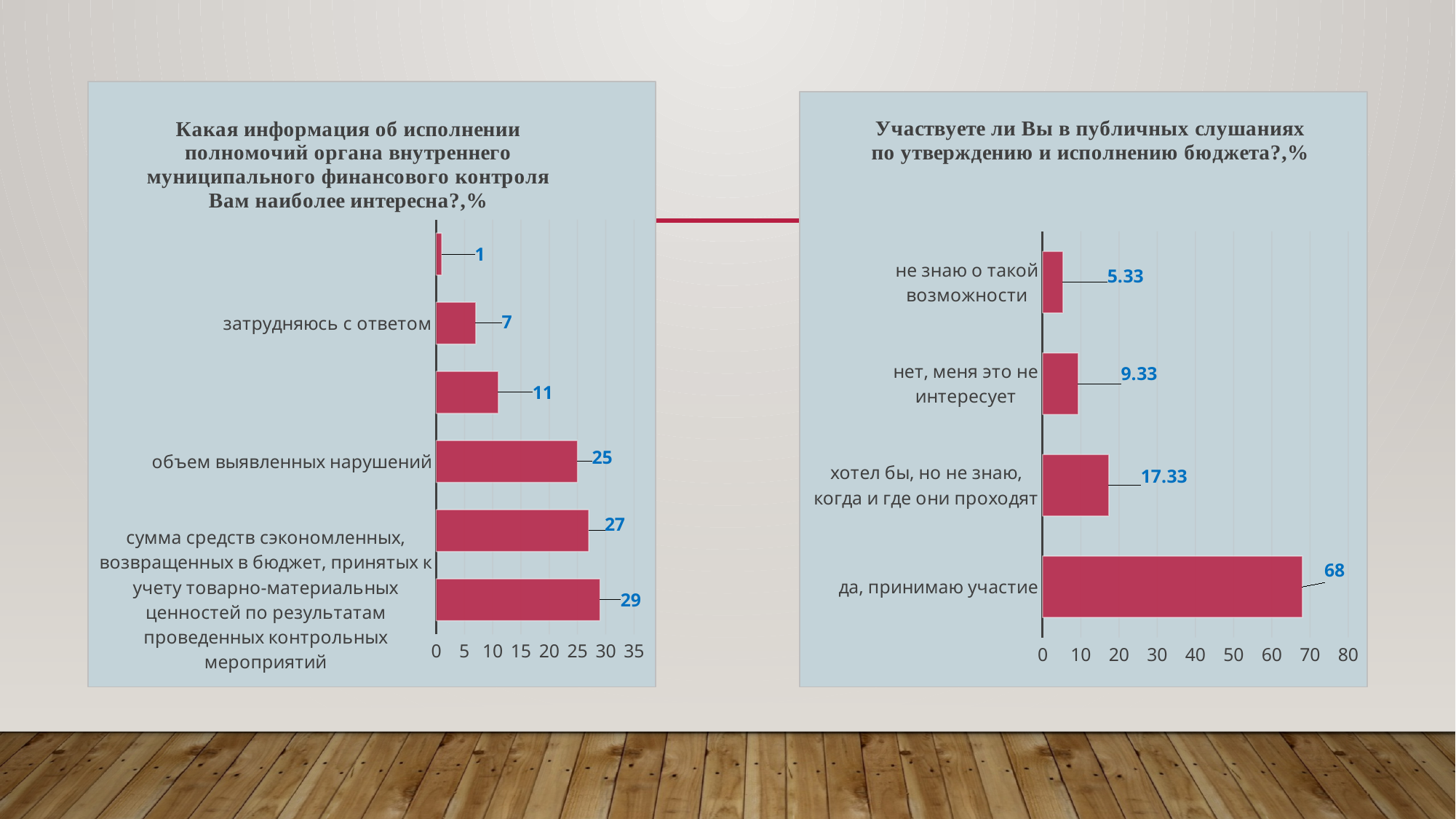
In the left chart (Какая информация об исполнении полномочий...), what is the highest value shown on any bar? 29 In the right chart (Участвуете ли Вы в публичных слушаниях...), what is the value for "да, принимаю участие"? 68 What type of chart is the right chart (Участвуете ли Вы в публичных слушаниях...)? bar chart In the right chart (Участвуете ли Вы в публичных слушаниях...), what is the value for "не знаю о такой возможности"? 5.33 In the right chart (Участвуете ли Вы в публичных слушаниях...), what is the value for "хотел бы, но не знаю, когда и где они проходят"? 17.33 In the left chart (Какая информация об исполнении полномочий...), what is the value for "объем выявленных нарушений"? 25 In the left chart (Какая информация об исполнении полномочий...), what is the value for "затрудняюсь с ответом"? 7 In the right chart (Участвуете ли Вы в публичных слушаниях...), which category has the lowest value? не знаю о такой возможности In the left chart (Какая информация об исполнении полномочий...), which is larger: the value for "объем выявленных нарушений" or the value for "затрудняюсь с ответом"? объем выявленных нарушений In the left chart (Какая информация об исполнении полномочий...), how many bars are plotted? 6 In the right chart (Участвуете ли Вы в публичных слушаниях...), how many categories are shown? 4 In the right chart (Участвуете ли Вы в публичных слушаниях...), what is the difference between "да, принимаю участие" and "нет, меня это не интересует"? 58.67